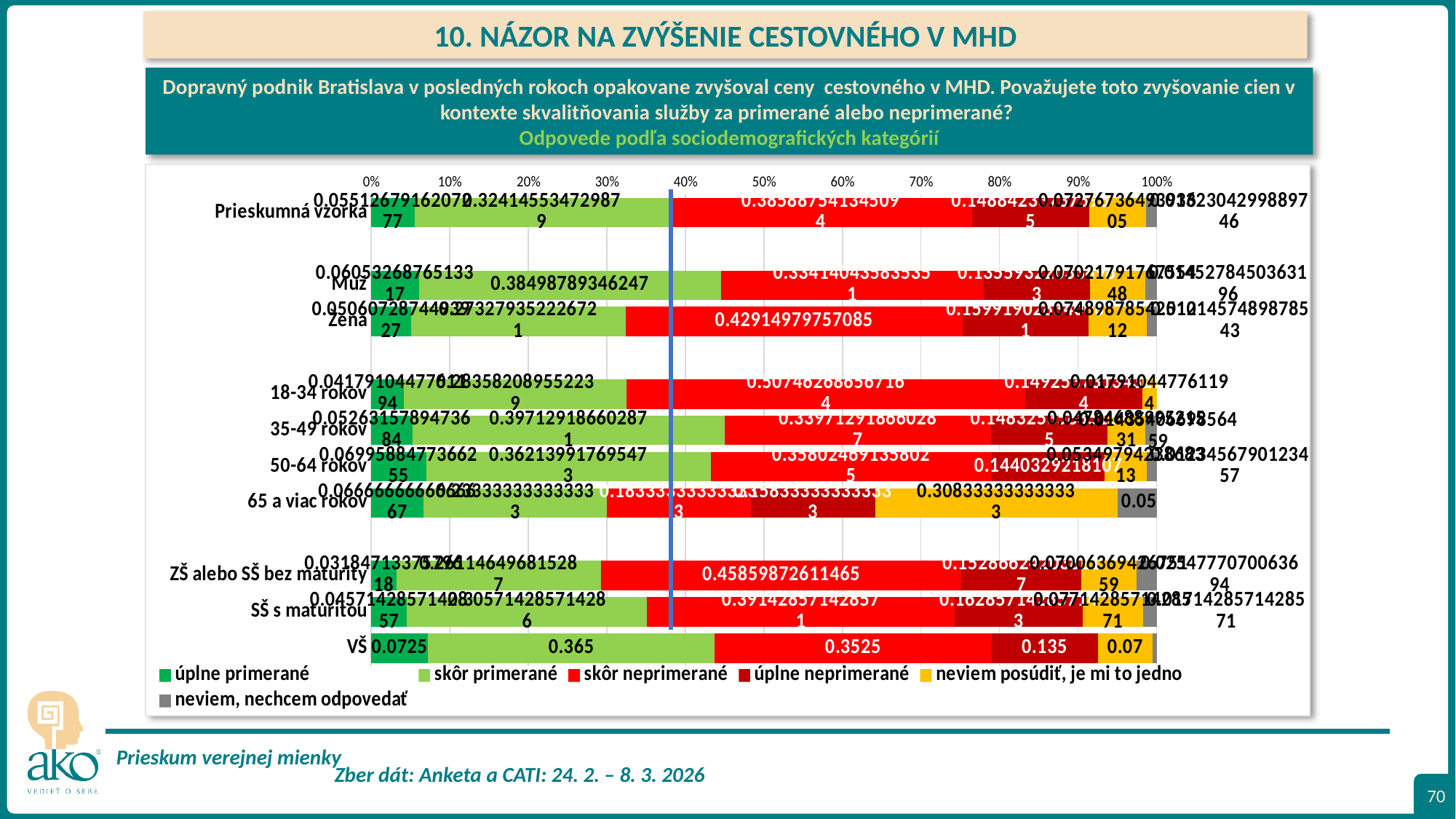
What is the value of 'skôr neprimerané' for the 'ZŠ alebo SŠ bez maturity' category? 0.45859872611465 What is the value of 'skôr primerané' for the VŠ category? 0.365 How many series does the legend list? 6 What kind of chart is shown on the slide? stacked bar chart What is the value of 'neviem, nechcem odpovedať' for the '65 a viac rokov' category? 0.05 How many sociodemographic categories (rows) are plotted in the chart? 10 What is the value of 'skôr neprimerané' for the VŠ category? 0.3525 What is the value of 'úplne neprimerané' for the VŠ category? 0.135 What is the value of 'skôr neprimerané' for the Žena category? 0.42914979757085 Which colour represents 'neviem, nechcem odpovedať' in the legend? grey Is the 'neviem posúdiť, je mi to jedno' value for '65 a viac rokov' greater or less than 20%? greater Which is larger for 'skôr neprimerané': the value for Muž or the value for Žena? Žena